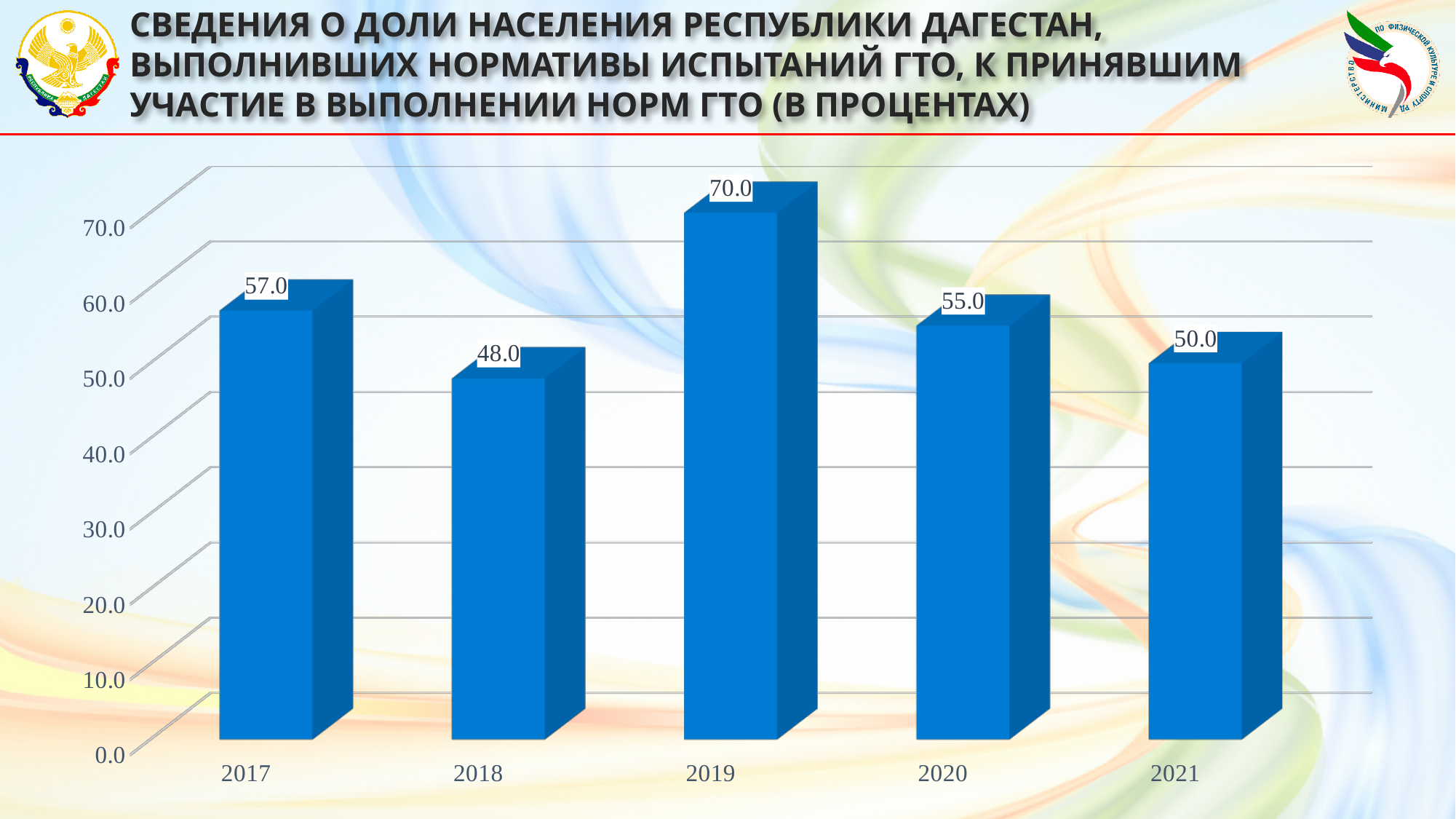
What is the value for 2018? 48.0 What is the value for 2019? 70.0 What is the value for 2017? 57.0 What is the difference between the values for 2017 and 2018? 9.0 Which year has the highest value? 2019 Is the value for 2018 greater or less than 50.0? less What is the difference between the values for 2019 and 2020? 15.0 Which is larger, the value for 2020 or the value for 2021? 2020 What is the value for 2021? 50.0 What kind of chart is shown on the slide? bar chart Which year has the lowest value? 2018 How many years are shown on the chart? 5